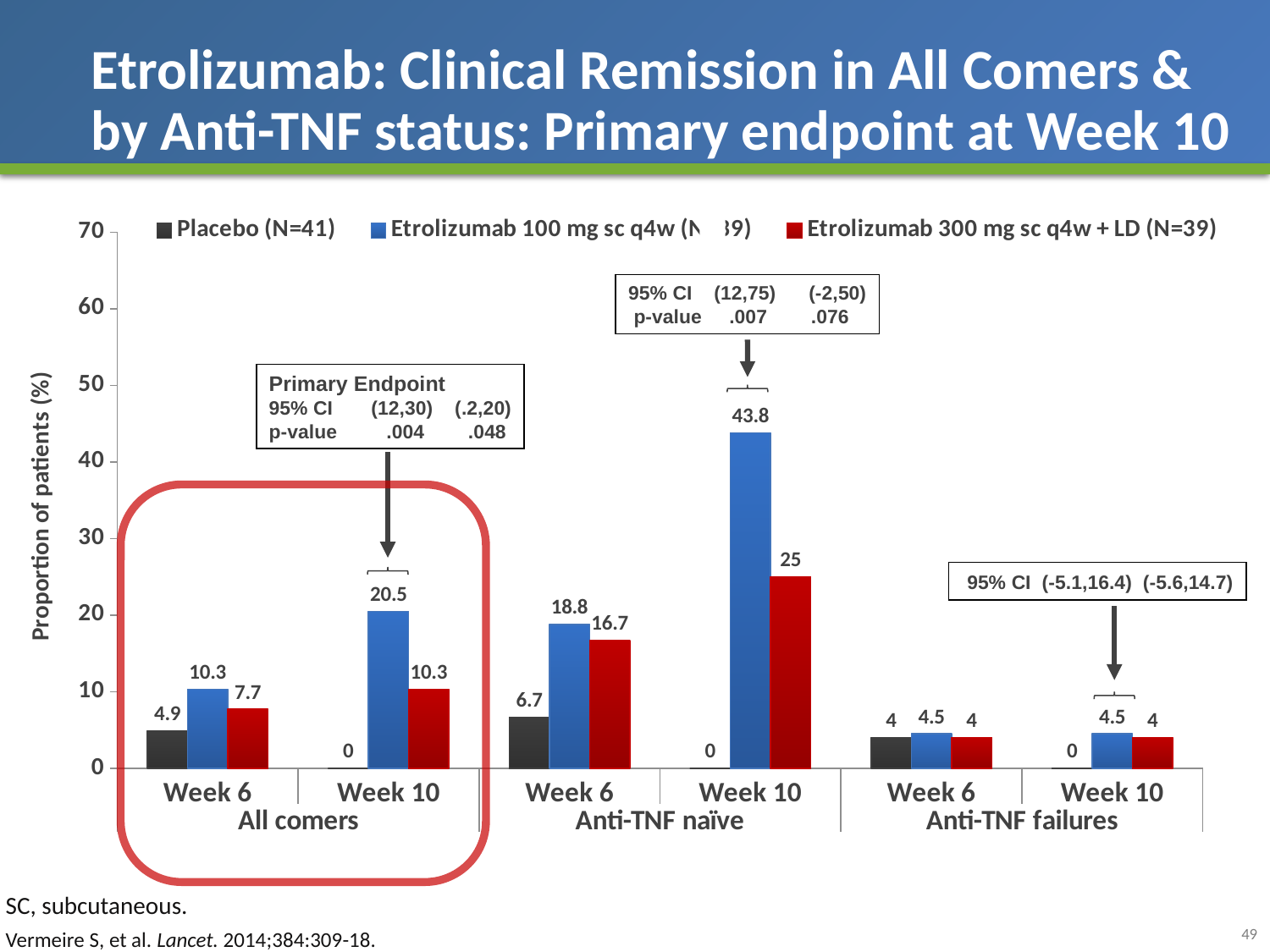
What kind of chart is shown on the slide? bar chart Is the value for Etrolizumab 100 mg sc q4w at Week 10 in the Anti-TNF naïve group greater or less than 40? greater Which bar has the highest value on the chart? Etrolizumab 100 mg sc q4w, Week 10, Anti-TNF naïve What is the value for Placebo at Week 6 in the Anti-TNF naïve group? 6.7 What is the value for Etrolizumab 100 mg sc q4w at Week 10 in the All comers group? 20.5 How many series does the legend list? 3 At Week 6 in the Anti-TNF naïve group, which is larger: the Etrolizumab 100 mg sc q4w value or the Etrolizumab 300 mg sc q4w + LD value? Etrolizumab 100 mg sc q4w What is the value for Placebo at Week 10 in the Anti-TNF failures group? 0 What is the difference between the Etrolizumab 100 mg sc q4w and Placebo values at Week 6 in the All comers group? 5.4 What is the label of the y axis? Proportion of patients (%) What is the difference between the Etrolizumab 100 mg sc q4w and Etrolizumab 300 mg sc q4w + LD values at Week 10 in the Anti-TNF naïve group? 18.8 What is the value for Etrolizumab 300 mg sc q4w + LD at Week 10 in the Anti-TNF naïve group? 25